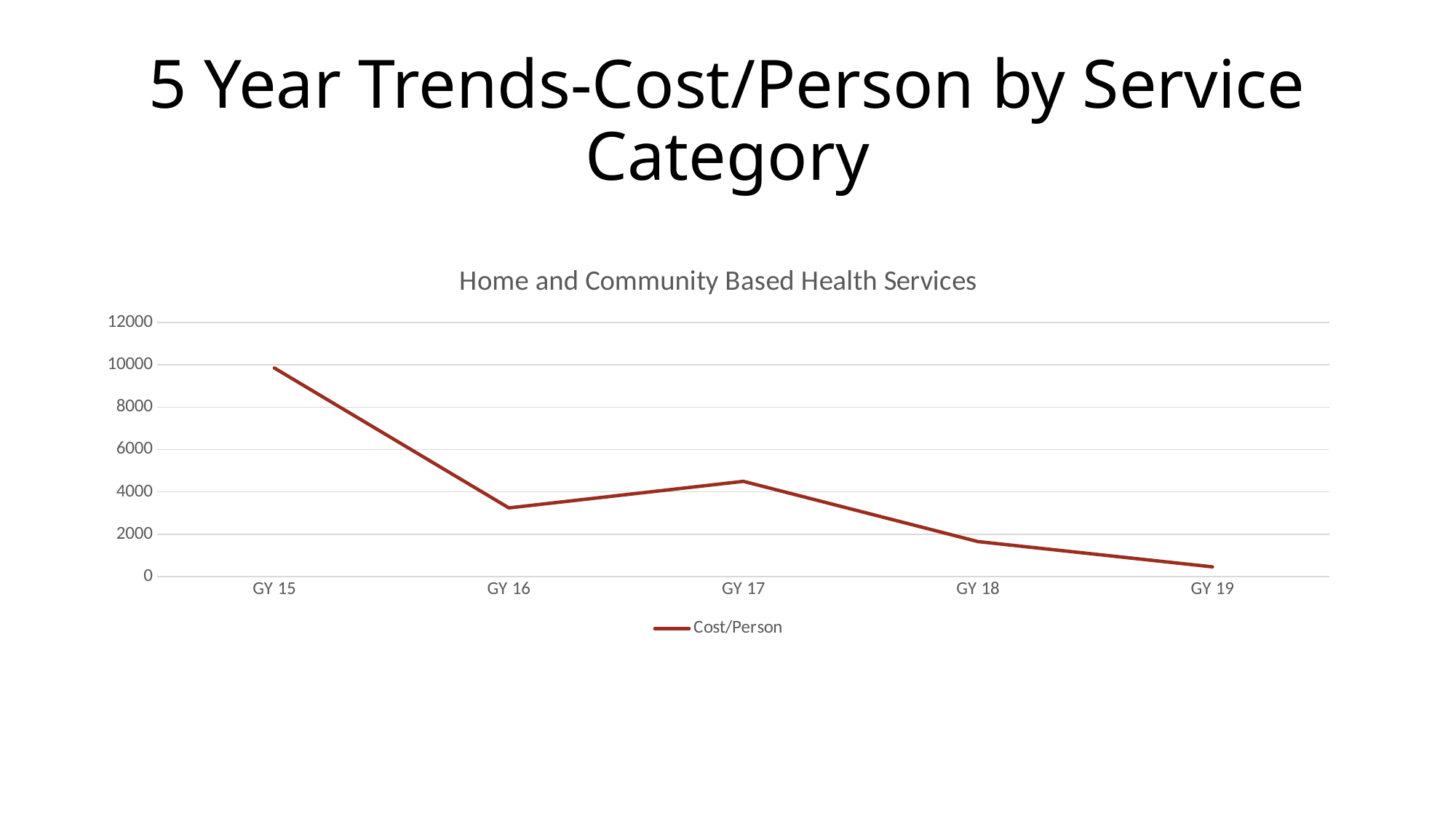
How many series does the legend list? 1 Which year has the lowest Cost/Person? GY 19 Overall, does the Cost/Person rise or fall from GY 15 to GY 19? fall Is the Cost/Person for GY 16 greater or less than 4000? less Is the Cost/Person for GY 15 greater or less than 8000? greater What is the name of the series shown in the legend? Cost/Person Which year has the highest Cost/Person? GY 15 What type of chart is shown on the slide? line chart Which is larger, the Cost/Person for GY 17 or for GY 18? GY 17 Is the Cost/Person for GY 19 greater or less than 2000? less How many points are plotted along the x axis? 5 What is the title of the chart? Home and Community Based Health Services